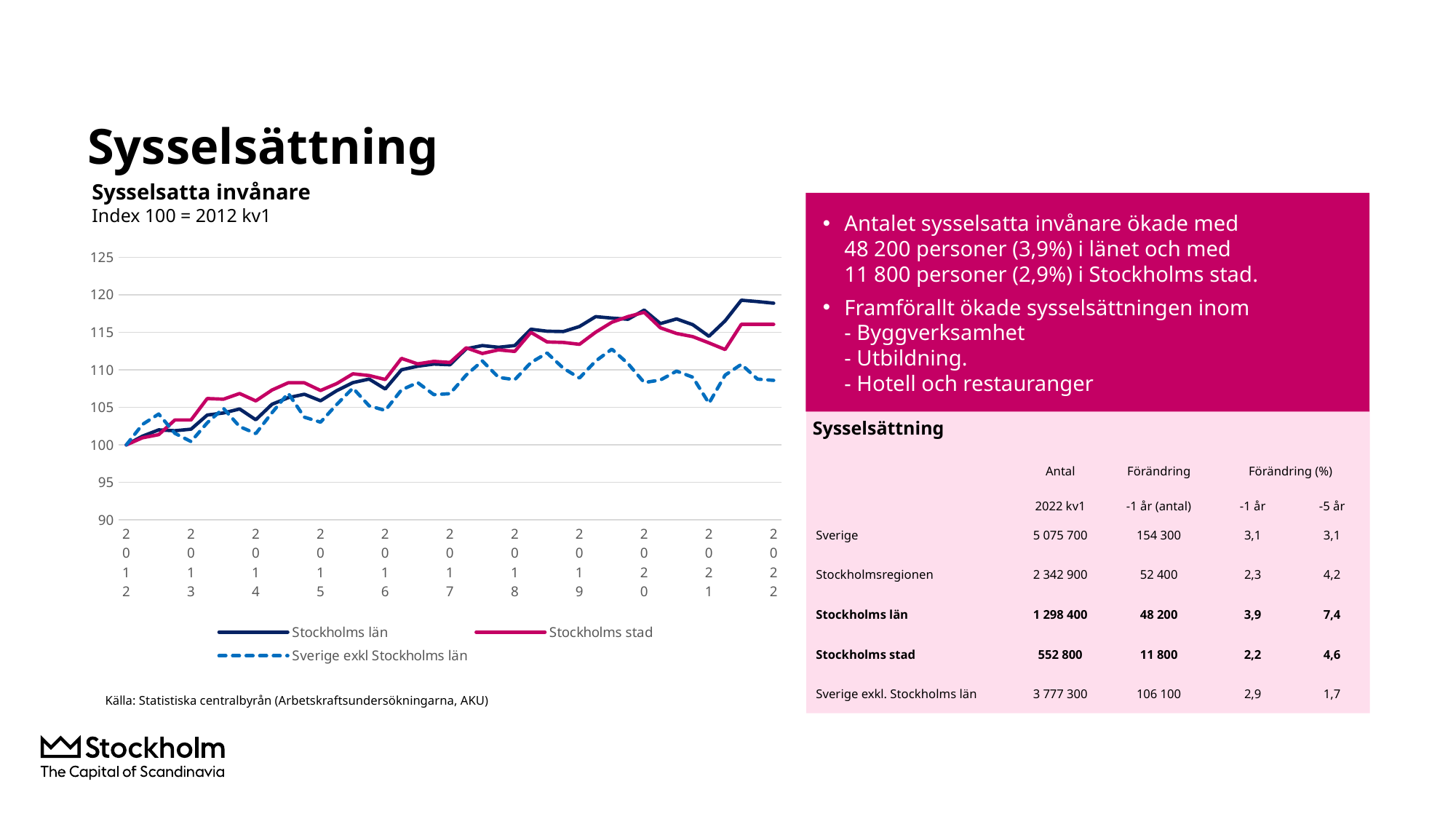
What is the title of the chart? Sysselsatta invånare Is the value for Stockholms län at the end of 2022 greater or less than 115? greater Which series has the highest value at the end of the chart in 2022? Stockholms län Which series has the lowest value at the end of the chart in 2022? Sverige exkl Stockholms län Does the Stockholms län series rise or fall overall from 2012 to 2022? Rise What is the index value of all three series at the start of the chart (2012 kv1)? 100 How many series does the chart legend list? 3 Which series in the chart is drawn with a dashed line? Sverige exkl Stockholms län What kind of chart is shown on the slide? Line chart At the end of 2022, which is larger: the value for Stockholms stad or the value for Sverige exkl Stockholms län? Stockholms stad Is the value for Sverige exkl Stockholms län at the end of 2022 greater or less than 110? less How many year labels are shown on the x axis of the chart? 11